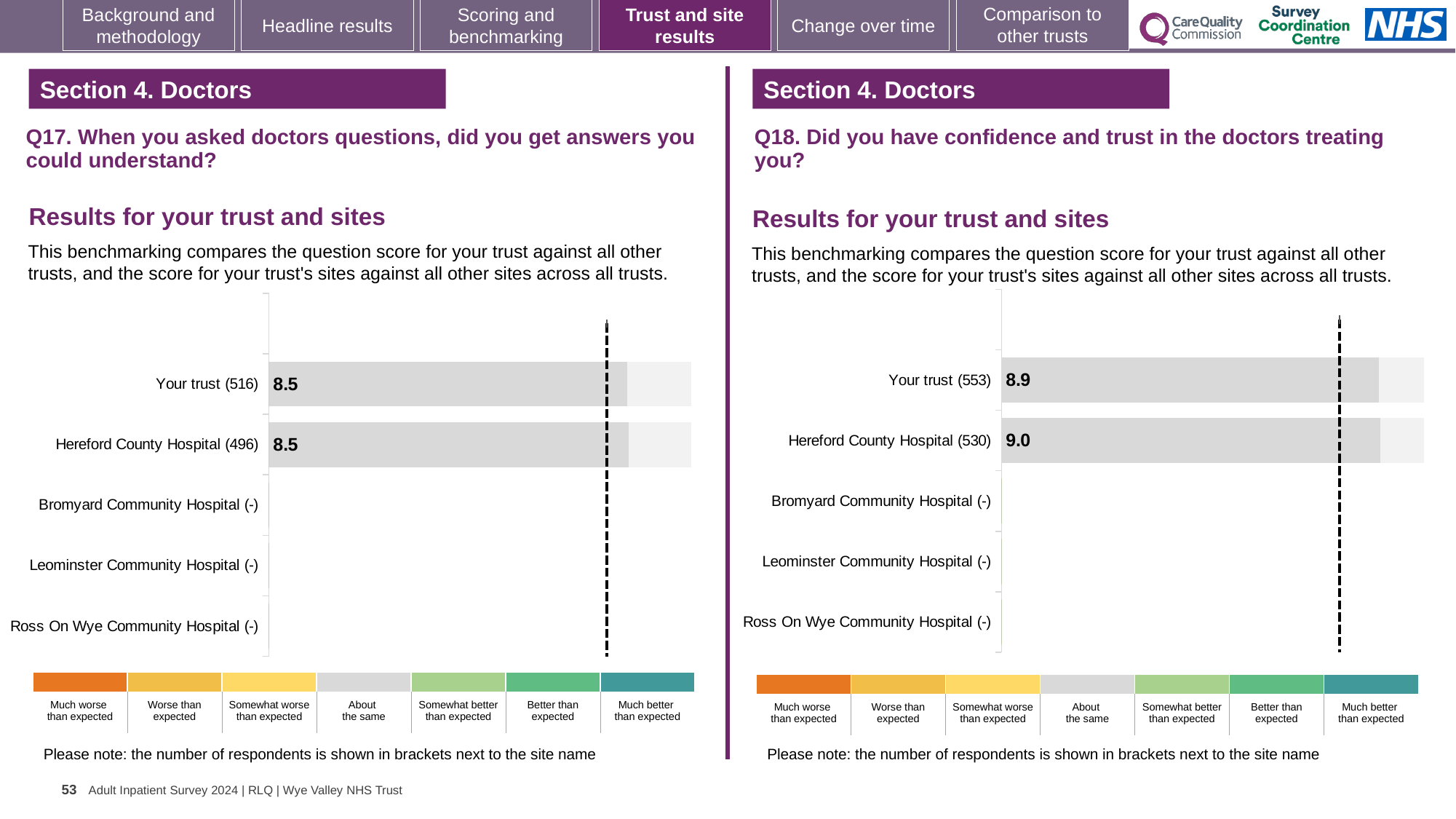
On the Q18 chart (right), which has the higher score: Your trust or Hereford County Hospital? Hereford County Hospital On the Q18 chart (right), how many respondents are shown in brackets for Hereford County Hospital? 530 On the Q17 chart (left), how many respondents are shown in brackets for Your trust? 516 On the Q18 chart (right), what is the score for Hereford County Hospital? 9.0 On the Q17 chart (left), what is the score for Hereford County Hospital? 8.5 On the Q18 chart (right), what is the difference between the Hereford County Hospital score and the Your trust score? 0.1 On the Q17 chart (left), how many sites have no score shown (marked with a dash)? 3 On the Q17 chart (left), what is the score for Your trust? 8.5 On the Q18 chart (right), what is the score for Your trust? 8.9 On the Q18 chart (right), is the score for Your trust greater or less than the score for Hereford County Hospital? less What kind of chart is used on the Q18 chart (right)? Bar chart On the Q17 chart (left), how many sites or rows are listed on the vertical axis? 5